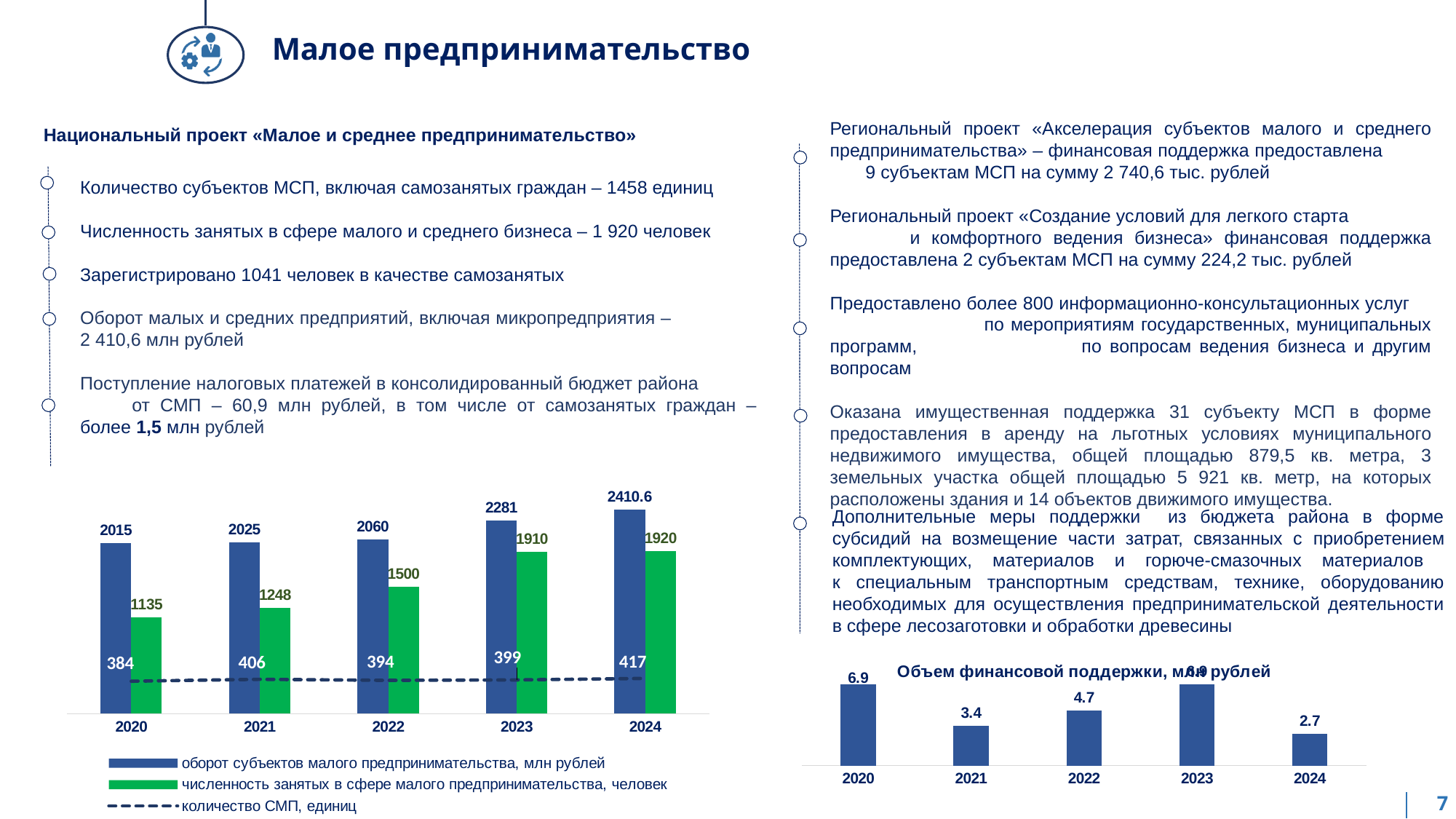
In the left chart, is the количество СМП higher in 2021 or in 2022? 2021 In the left chart, what is the value of оборот субъектов малого предпринимательства for 2024? 2410.6 In the chart titled 'Объем финансовой поддержки, млн рублей', what is the difference between the values for 2022 and 2021? 1.3 In the chart titled 'Объем финансовой поддержки, млн рублей', which year has the lowest value? 2024 What kind of chart is the chart titled 'Объем финансовой поддержки, млн рублей'? bar chart In the left chart, what is the количество СМП for 2021? 406 In the left chart, does the оборот субъектов малого предпринимательства rise or fall from 2020 to 2024? rise In the left chart, what is the численность занятых в сфере малого предпринимательства for 2022? 1500 In the chart titled 'Объем финансовой поддержки, млн рублей', what is the value for 2021? 3.4 How many series does the legend of the left chart list? 3 In the left chart, which year has the lowest численность занятых в сфере малого предпринимательства? 2020 In the left chart, what is the difference between the оборот values for 2023 and 2022? 221